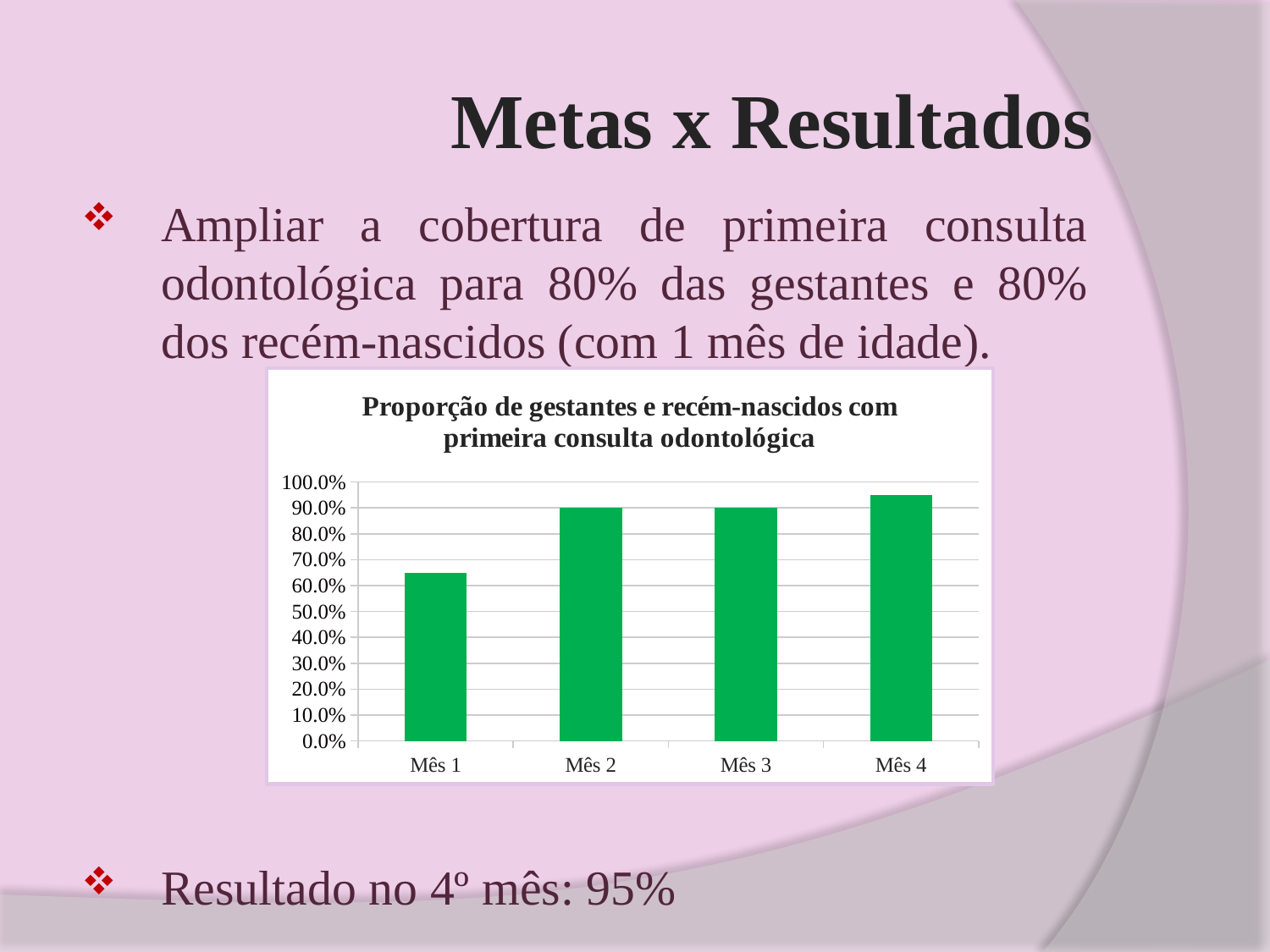
According to the slide, what was the result in the 4th month (Mês 4)? 95% Which month has the highest proportion in the chart? Mês 4 What kind of chart is shown on the slide? bar chart Is the value for Mês 1 greater or less than 60.0%? greater Is the value for Mês 1 greater or less than 70.0%? less What is the proportion shown for Mês 2? 90.0% How many months (categories) are plotted on the x axis of the chart? 4 Which month has the lowest proportion in the chart? Mês 1 Which is larger, the value for Mês 1 or the value for Mês 2? Mês 2 What is the title of the chart? Proporção de gestantes e recém-nascidos com primeira consulta odontológica Do the values generally rise or fall from Mês 1 to Mês 4? rise What is the proportion shown for Mês 3? 90.0%